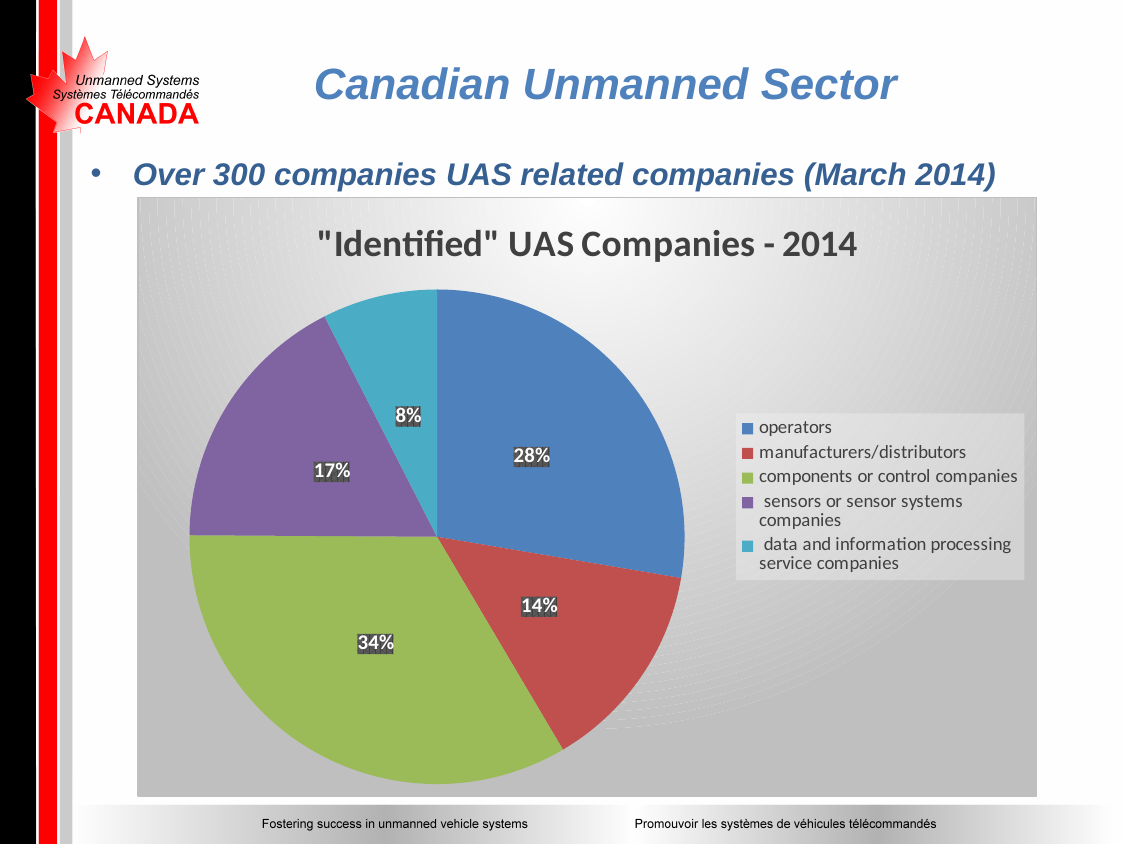
What is the difference in percentage points between components or control companies and operators? 6 What share of the pie do operators represent? 28% What percentage is shown for manufacturers/distributors? 14% What kind of chart is shown on the slide? pie chart What is the title of the chart? "Identified" UAS Companies - 2014 Which category has the smallest slice of the pie? data and information processing service companies What percentage is shown for components or control companies? 34% How many categories does the legend list? 5 What percentage is shown for sensors or sensor systems companies? 17% Which is larger, the share for operators or the share for sensors or sensor systems companies? operators Which category has the largest slice of the pie? components or control companies What percentage is shown for data and information processing service companies? 8%